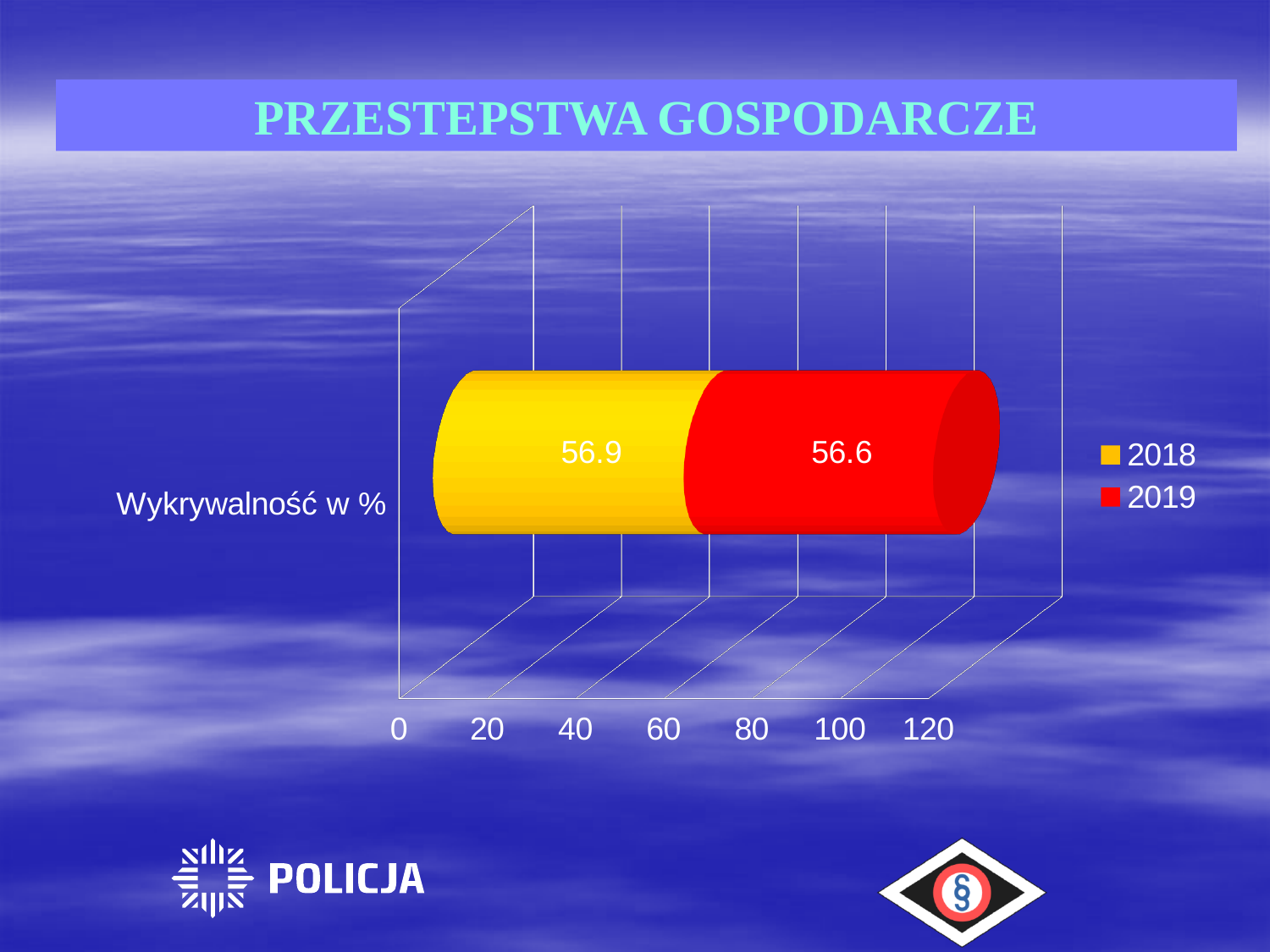
What is the value for 2018 in the chart? 56.9 How many categories are shown on the chart? 1 How many series does the legend list? 2 What is the total of the stacked bar for Wykrywalność w %? 113.5 What is the label of the category shown on the chart? Wykrywalność w % What is the title of the slide above the chart? PRZESTEPSTWA GOSPODARCZE What kind of chart is shown on the slide? Stacked bar chart Is the total of the stacked bar greater or less than 100? greater What is the value for 2019 in the chart? 56.6 Which series has the higher value, 2018 or 2019? 2018 Which colour represents the 2019 series in the chart? Red What is the difference between the 2018 value and the 2019 value? 0.3